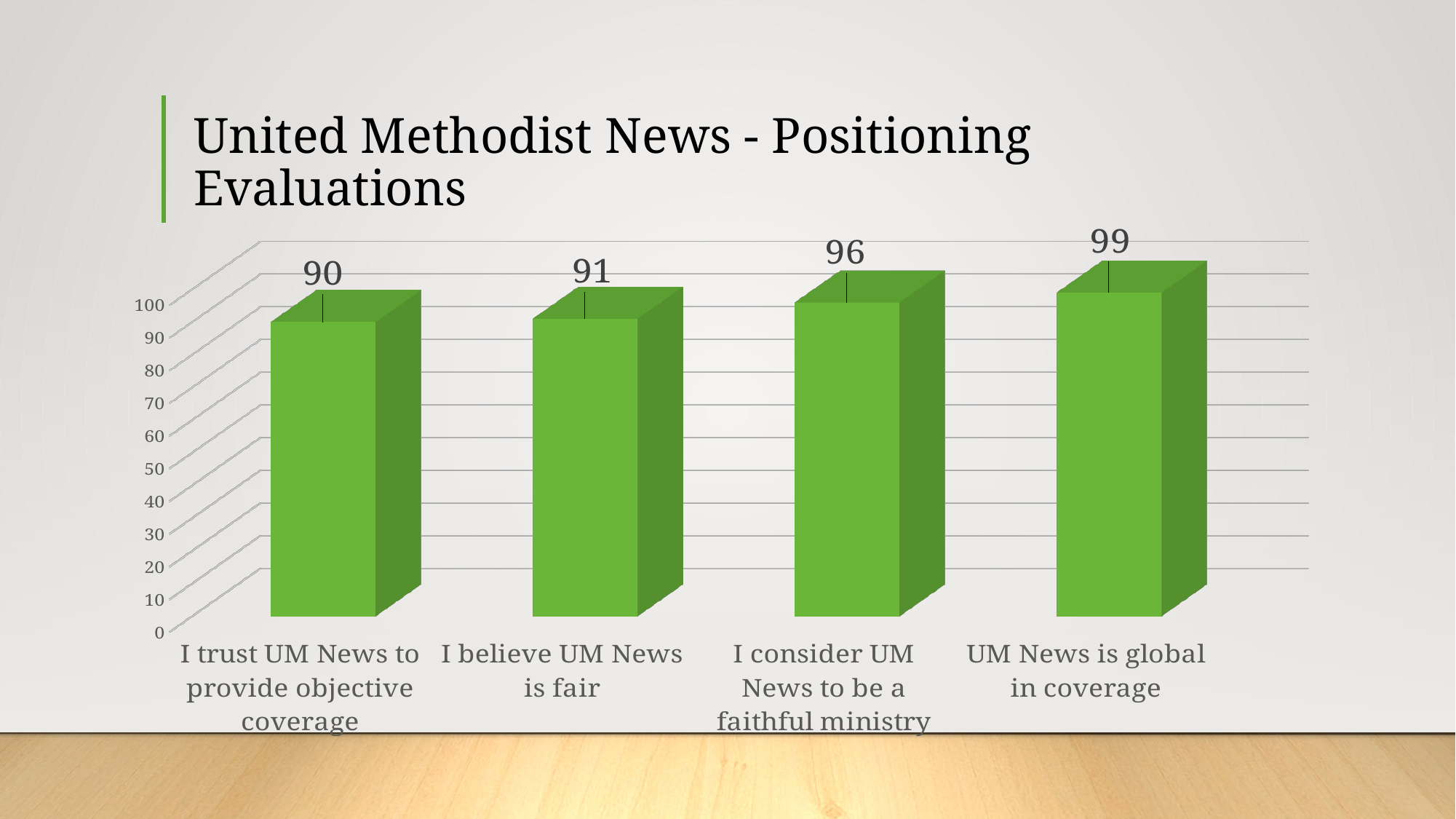
Do the values rise or fall from left to right across the categories? Rise Which category has the lowest value? I trust UM News to provide objective coverage How many categories are shown in the chart? 4 What is the value for "I believe UM News is fair"? 91 Which is larger: the value for "I consider UM News to be a faithful ministry" or the value for "I believe UM News is fair"? I consider UM News to be a faithful ministry What is the value for "UM News is global in coverage"? 99 What is the difference between the values for "UM News is global in coverage" and "I trust UM News to provide objective coverage"? 9 Which category has the highest value? UM News is global in coverage What is the value for "I consider UM News to be a faithful ministry"? 96 What is the value for "I trust UM News to provide objective coverage"? 90 What kind of chart is shown on the slide? Bar chart What is the difference between the values for "I consider UM News to be a faithful ministry" and "I believe UM News is fair"? 5